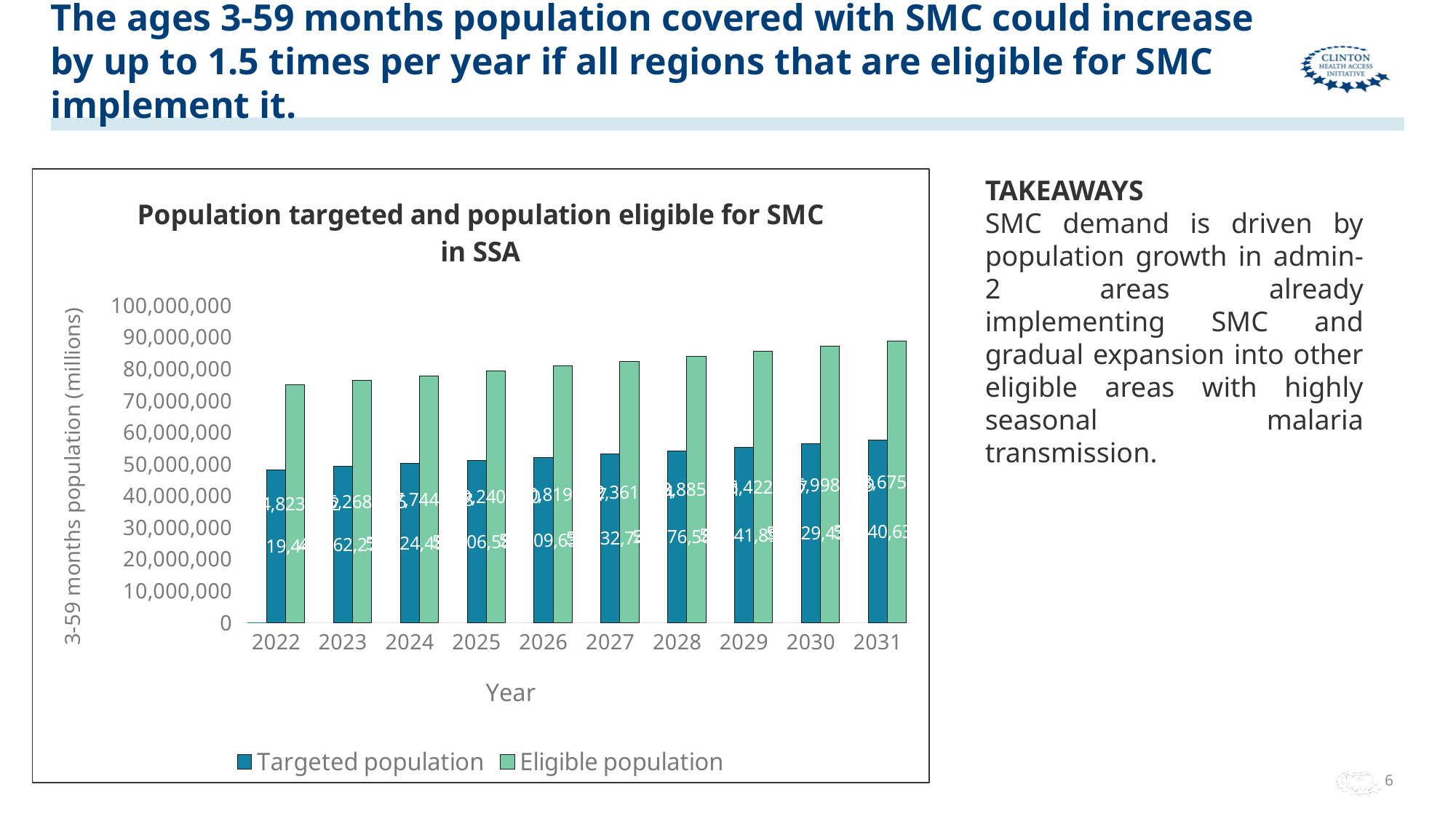
Does the targeted population rise or fall from 2022 to 2031? rise How many series does the legend list? 2 What type of chart is shown on the slide? bar chart Which year has the lowest targeted population? 2022 In 2025, which is larger: the targeted population or the eligible population? Eligible population Is the eligible population in 2022 greater or less than 80,000,000? less Is the targeted population in 2022 greater or less than 40,000,000? greater What is the title of the chart? Population targeted and population eligible for SMC in SSA Which year has the highest eligible population? 2031 Is the targeted population in 2031 greater or less than 50,000,000? greater How many years are shown on the x axis? 10